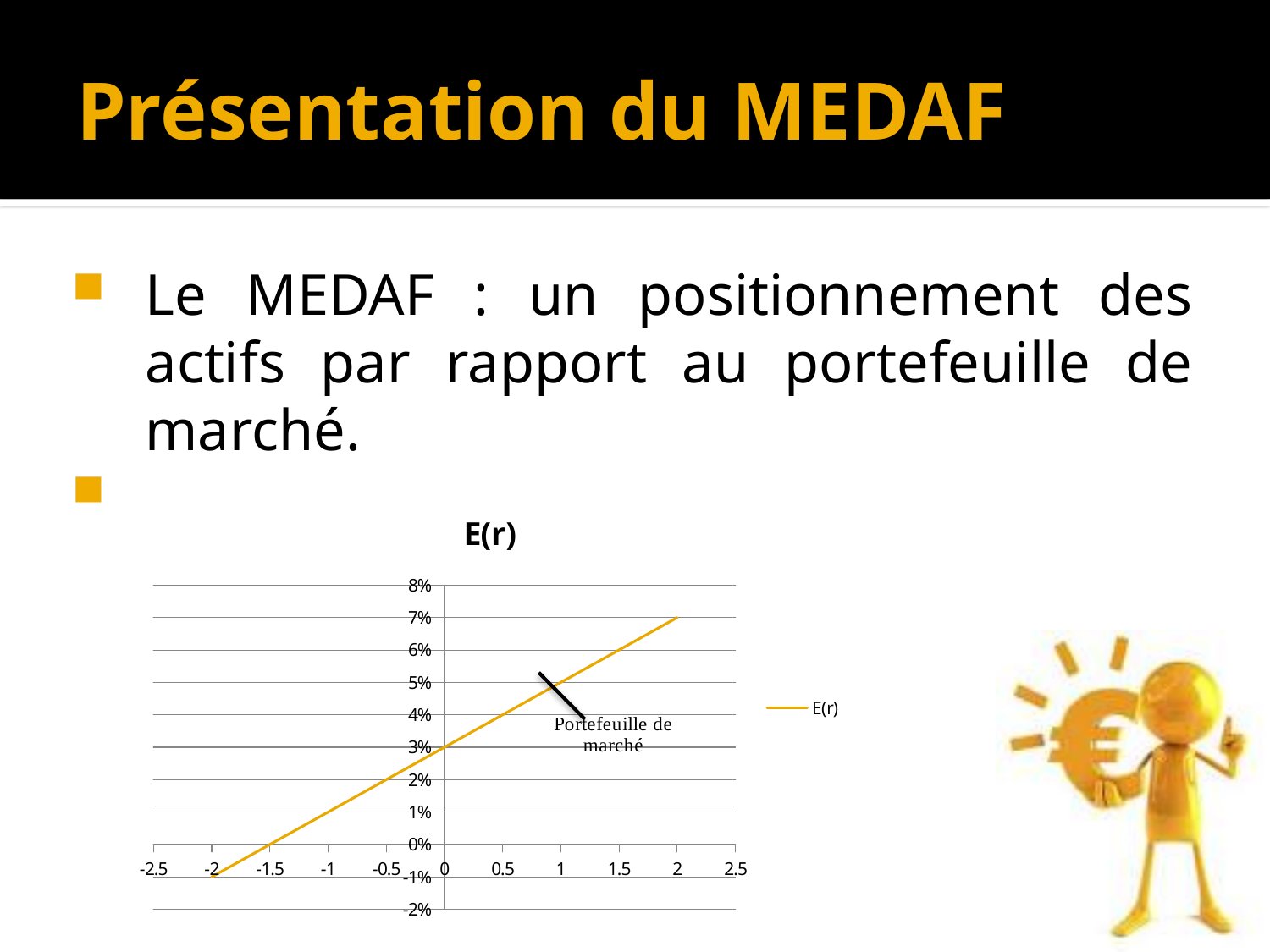
At which x-axis value does the E(r) line cross 0%? -1.5 Is the value of E(r) at x = 1.5 greater or less than 5%? greater What type of chart is shown on the slide? line chart What is the title of the chart? E(r) Does the E(r) line rise or fall as the x-axis value increases? rise What is the name of the series shown in the legend? E(r) What is the value of E(r) where the line crosses the vertical axis at x = 0? 3% What is the value of E(r) at x = 2, the right end of the line? 7% Is the value of E(r) at x = -1 greater or less than 2%? less How many series does the legend list? 1 What is the value of E(r) at x = -2, the left end of the line? -1%